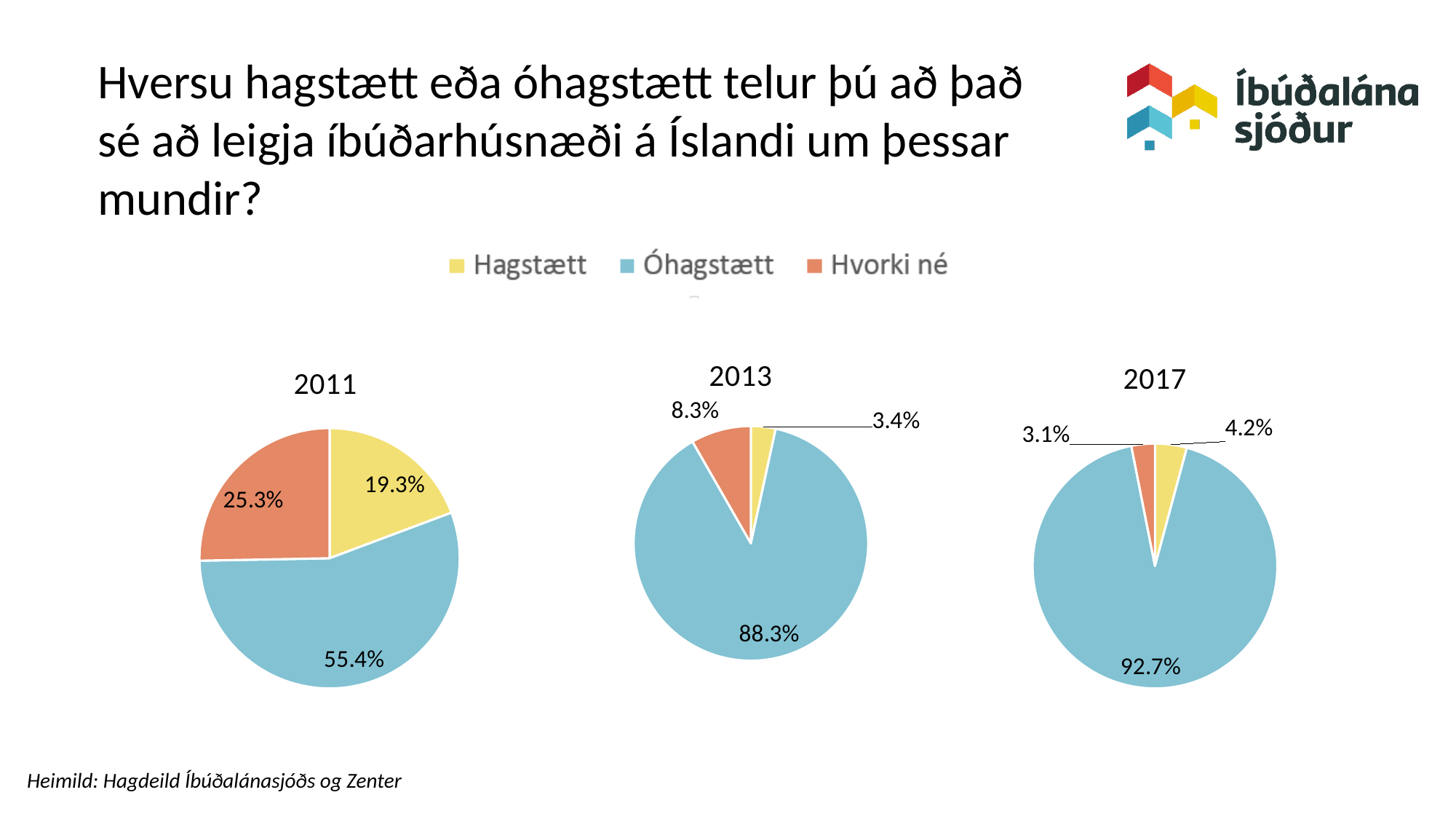
In the 2011 pie chart, what share is Óhagstætt? 55.4% In the 2013 pie chart, which category has the smallest slice? Hagstætt In the 2017 pie chart, what share is Hagstætt? 4.2% In the 2011 pie chart, which is larger: Hvorki né or Hagstætt? Hvorki né What kind of chart is used for the 2013 data? Pie chart In the 2017 pie chart, what share is Óhagstætt? 92.7% What is the difference between the Óhagstætt share in the 2017 pie chart and the Óhagstætt share in the 2011 pie chart? 37.3% In the 2017 pie chart, which category has the smallest slice? Hvorki né In the 2013 pie chart, what share is Hvorki né? 8.3% How many series does the legend list? 3 In the 2011 pie chart, what share is Hagstætt? 19.3% In the 2011 pie chart, which category has the largest slice? Óhagstætt